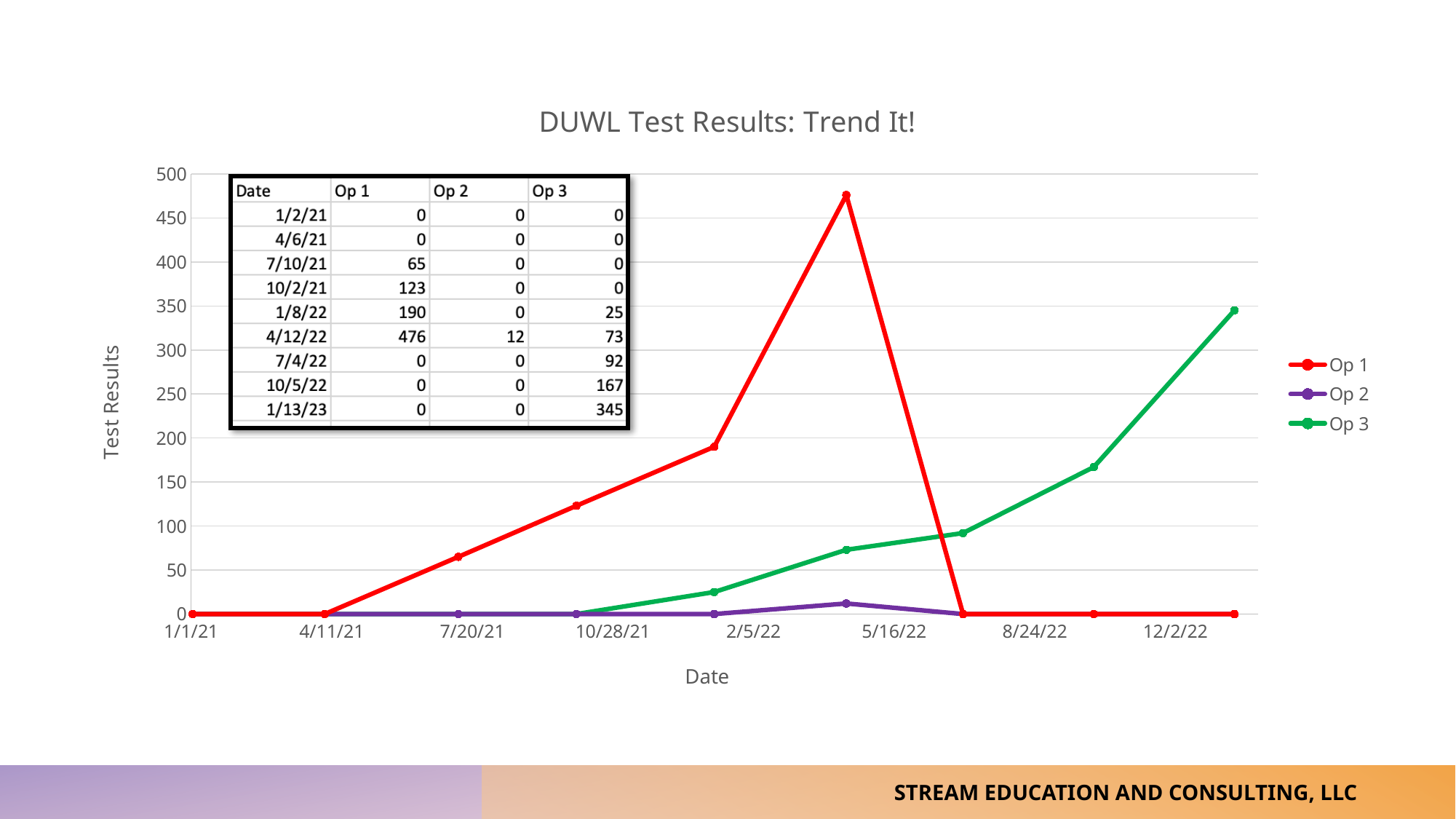
What is the Op 3 value on 1/13/23? 345 What kind of chart is shown on the slide? line chart What is the Op 1 value on 4/12/22? 476 What is the Op 1 value on 10/2/21? 123 Does the Op 3 series rise or fall from 1/8/22 to 1/13/23? rise What is the title of the chart? DUWL Test Results: Trend It! How many series does the legend list? 3 On which date does Op 1 reach its highest value? 4/12/22 How many dates are listed in the data table? 9 Which is larger on 10/5/22, the Op 3 value or the Op 1 value? Op 3 What is the difference between the Op 1 value on 4/12/22 and the Op 3 value on 4/12/22? 403 What is the Op 2 value on 4/12/22? 12